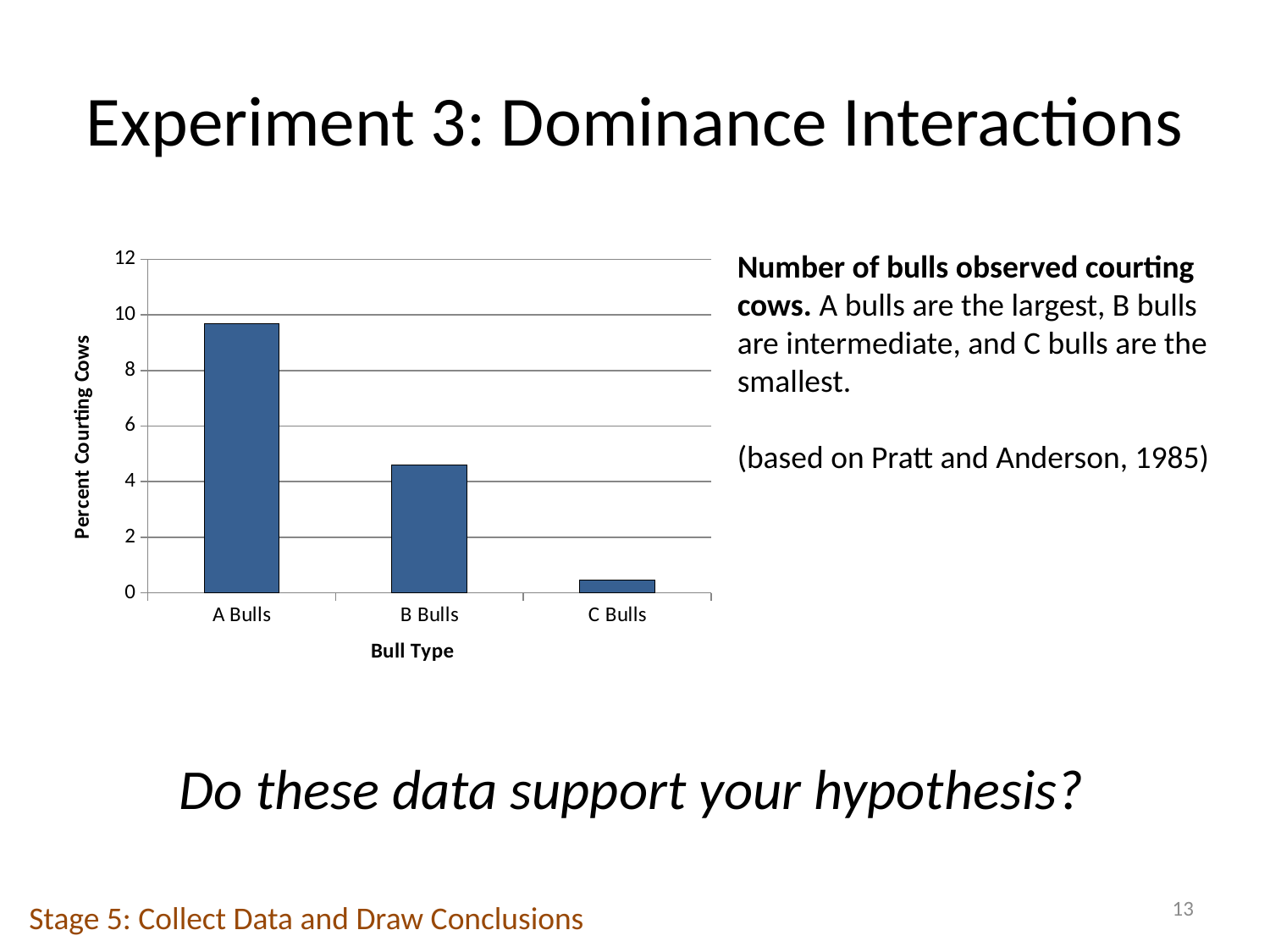
Do the values rise or fall from A Bulls to C Bulls along the x axis? fall What is the title of the horizontal axis of the chart? Bull Type What kind of chart is shown on the slide? bar chart Is the value for B Bulls greater or less than 4? greater How many bull types are plotted on the chart? 3 Is the value for B Bulls greater or less than 6? less Which bull type has the lowest percent courting cows? C Bulls Which bull type has the highest percent courting cows? A Bulls Is the value for A Bulls greater or less than 8? greater What is the title of the vertical axis of the chart? Percent Courting Cows Which has a higher percent courting cows, B Bulls or C Bulls? B Bulls